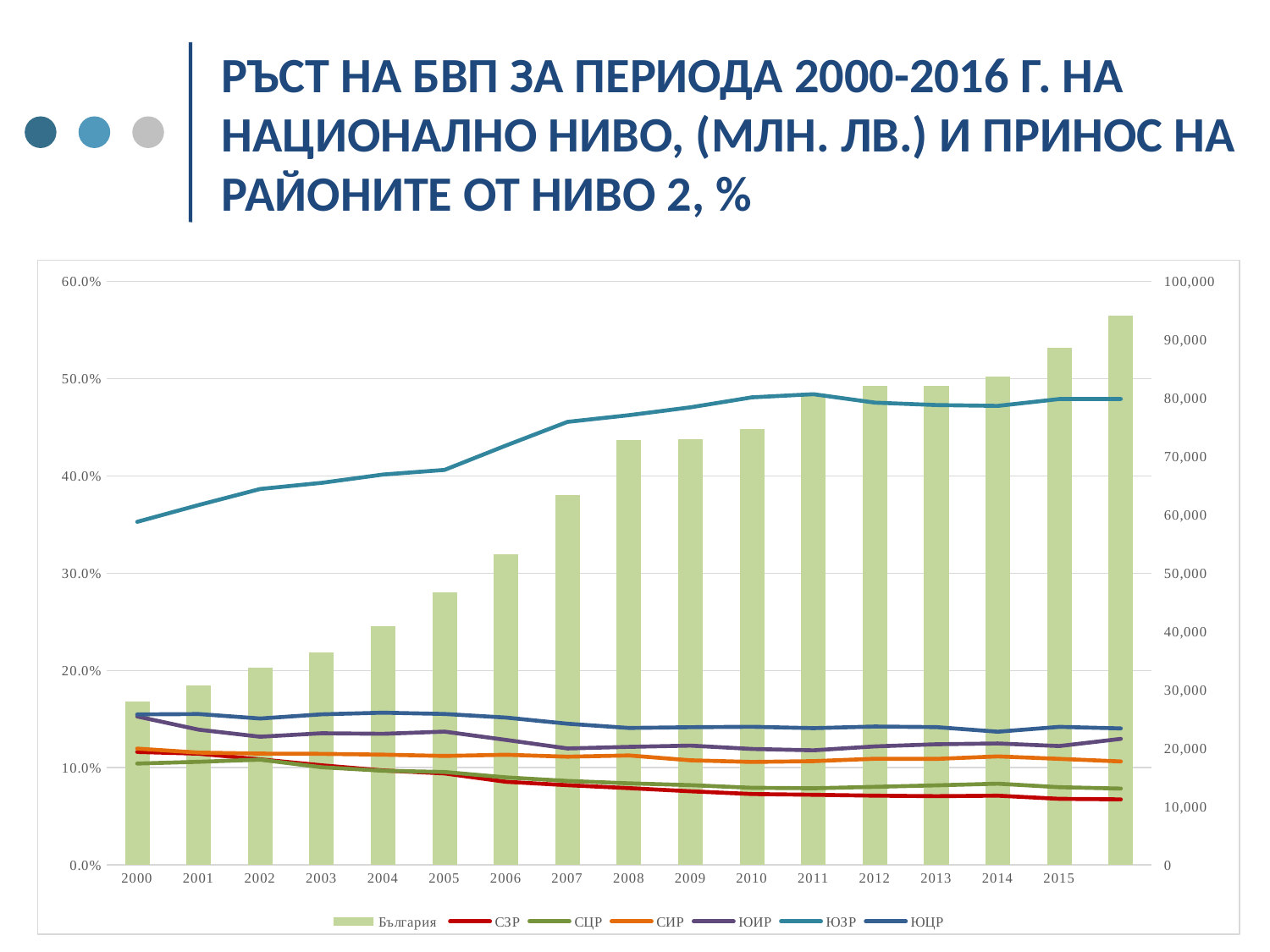
What colour are the bars for България? Light green Which region's line is the lowest in 2015? СЗР How many series does the legend list? 7 Is the bar for България in 2015 greater or less than 80,000? greater What kind of chart is shown on the slide? Combined bar and line chart Which region's line is the highest across the whole period? ЮЗР Does the СЗР line rise or fall from 2000 to 2015? Fall Is the value for ЮЗР in 2000 greater or less than 30.0%? greater Do the bars for България rise or fall from 2000 to 2015? Rise In 2015, which line is higher, ЮИР or СИР? ЮИР How many years are labeled on the x axis? 16 Is the bar for България in 2000 greater or less than 40,000? less